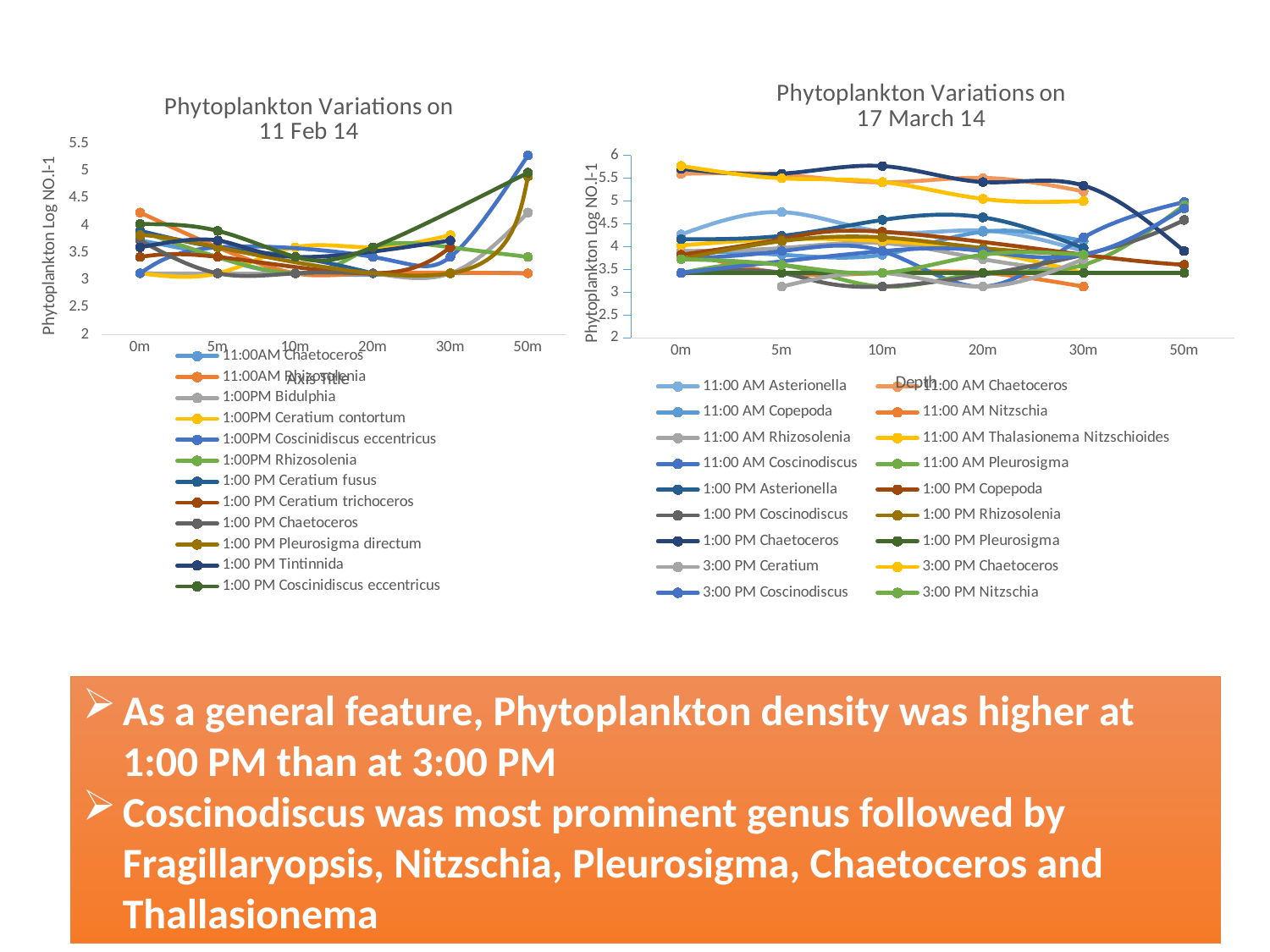
In the 'Phytoplankton Variations on 17 March 14' chart, is the lowest value plotted at 5m greater or less than 3.5? less What kind of chart is the 'Phytoplankton Variations on 17 March 14' chart? line chart In the 'Phytoplankton Variations on 11 Feb 14' chart, is the highest value plotted at 50m greater or less than 5? greater How many series does the legend of the 'Phytoplankton Variations on 11 Feb 14' chart list? 12 What kind of chart is the 'Phytoplankton Variations on 11 Feb 14' chart? line chart What is the x-axis title of the 'Phytoplankton Variations on 17 March 14' chart? Depth In the 'Phytoplankton Variations on 17 March 14' chart, is the highest value plotted at 0m greater or less than 5.5? greater How many series does the legend of the 'Phytoplankton Variations on 17 March 14' chart list? 18 What is the title of the chart on the right of the slide? Phytoplankton Variations on 17 March 14 How many depth categories are shown on the x axis of the 'Phytoplankton Variations on 17 March 14' chart? 6 How many depth categories are shown on the x axis of the 'Phytoplankton Variations on 11 Feb 14' chart? 6